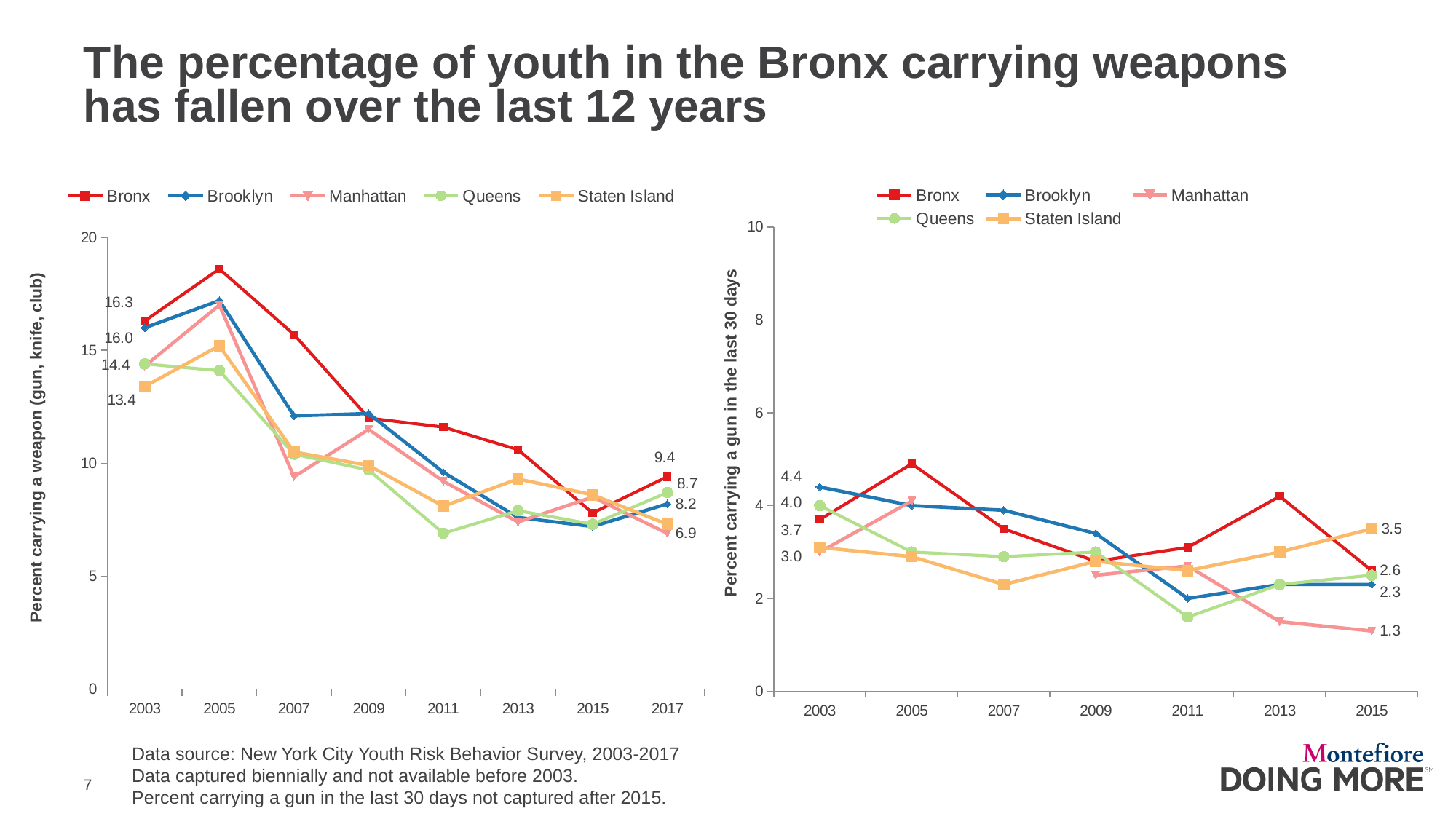
In the left chart (percent carrying a weapon), what is the value for the Bronx in 2017? 9.4 In the right chart (percent carrying a gun in the last 30 days), what is the value for Brooklyn in 2003? 4.4 How many years are plotted along the x axis of the left chart (percent carrying a weapon)? 8 In the left chart (percent carrying a weapon), which borough has the highest value in 2017? Bronx What kind of chart is the left chart, 'Percent carrying a weapon (gun, knife, club)'? Line chart In the left chart (percent carrying a weapon), by how much did the Bronx value fall from 2003 to 2017? 6.9 In the left chart (percent carrying a weapon), is the Bronx value in 2005 greater or less than 15? greater In the right chart (percent carrying a gun in the last 30 days), which is larger in 2015: Staten Island or the Bronx? Staten Island In the left chart (percent carrying a weapon), what is the value for the Bronx in 2003? 16.3 How many years are plotted along the x axis of the right chart (percent carrying a gun in the last 30 days)? 7 How many series does the legend of the left chart list? 5 In the right chart (percent carrying a gun in the last 30 days), which borough has the lowest value in 2015? Manhattan